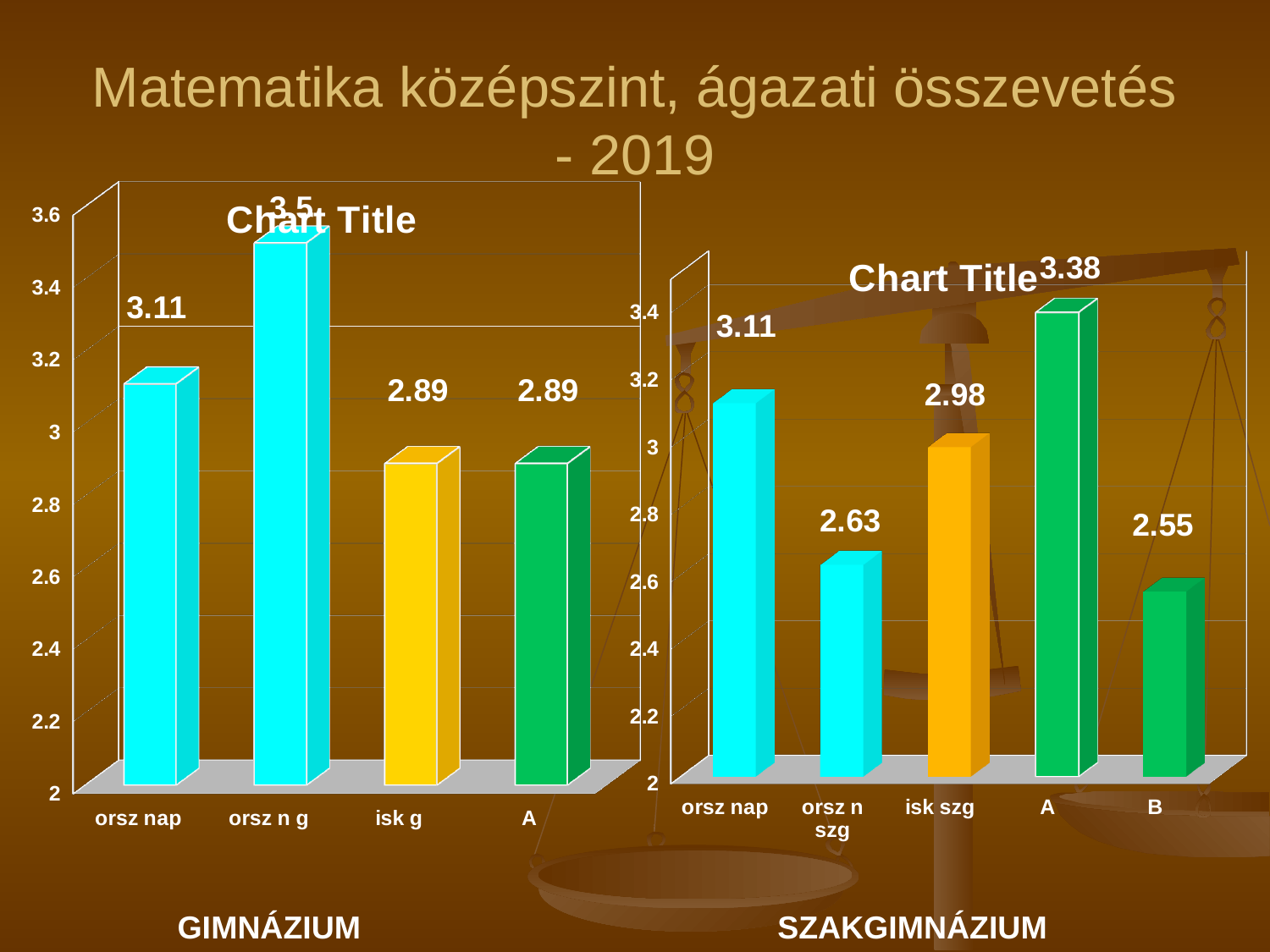
What kind of chart is the left chart (GIMNÁZIUM)? bar chart In the right chart (SZAKGIMNÁZIUM), which is larger, isk szg or orsz nap? orsz nap In the right chart (SZAKGIMNÁZIUM), how many categories are shown on the x axis? 5 In the right chart (SZAKGIMNÁZIUM), which category has the lowest value? B In the left chart (GIMNÁZIUM), what is the value for orsz n g? 3.5 In the right chart (SZAKGIMNÁZIUM), what is the value for orsz n szg? 2.63 In the left chart (GIMNÁZIUM), how many bars are plotted? 4 In the right chart (SZAKGIMNÁZIUM), what is the difference between A and B? 0.83 In the left chart (GIMNÁZIUM), which category has the highest value? orsz n g In the left chart (GIMNÁZIUM), what is the value for isk g? 2.89 In the left chart (GIMNÁZIUM), what is the difference between orsz n g and orsz nap? 0.39 In the right chart (SZAKGIMNÁZIUM), what is the value for A? 3.38